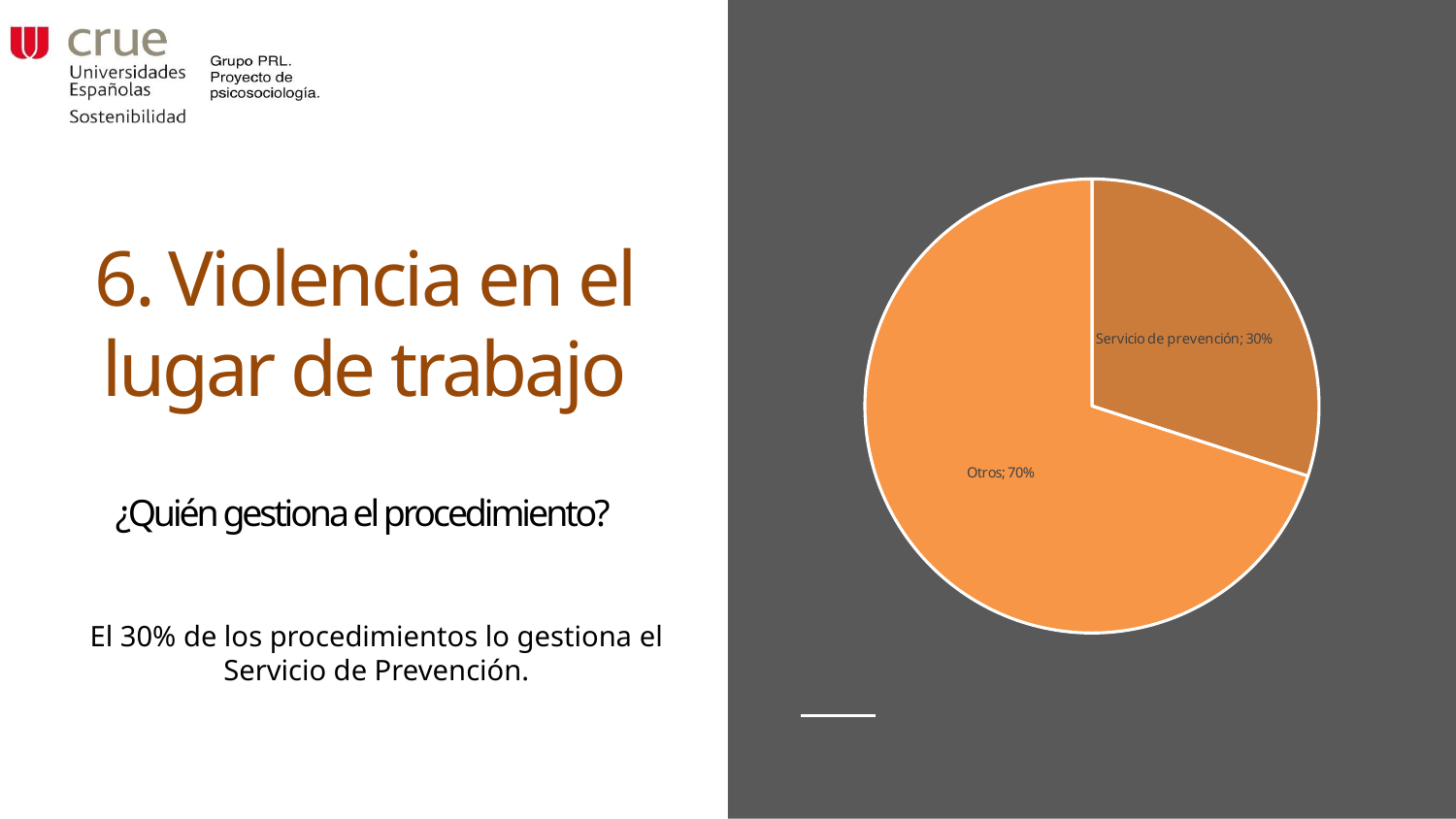
What share of the pie does "Servicio de prevención" represent? 30% What is the difference in percentage points between the "Otros" slice and the "Servicio de prevención" slice? 40 What kind of chart is shown on the slide? pie chart Is the share for "Otros" greater or less than 50%? greater Which slice of the pie is the largest? Otros What is the background colour of the panel containing the pie chart? dark grey How many slices does the pie chart have? 2 Which is larger, the "Otros" slice or the "Servicio de prevención" slice? Otros What share of the pie does "Otros" represent? 70% What question does the slide pose above the text about the chart? ¿Quién gestiona el procedimiento? Is the share for "Servicio de prevención" greater or less than 50%? less Which slice of the pie is the smallest? Servicio de prevención